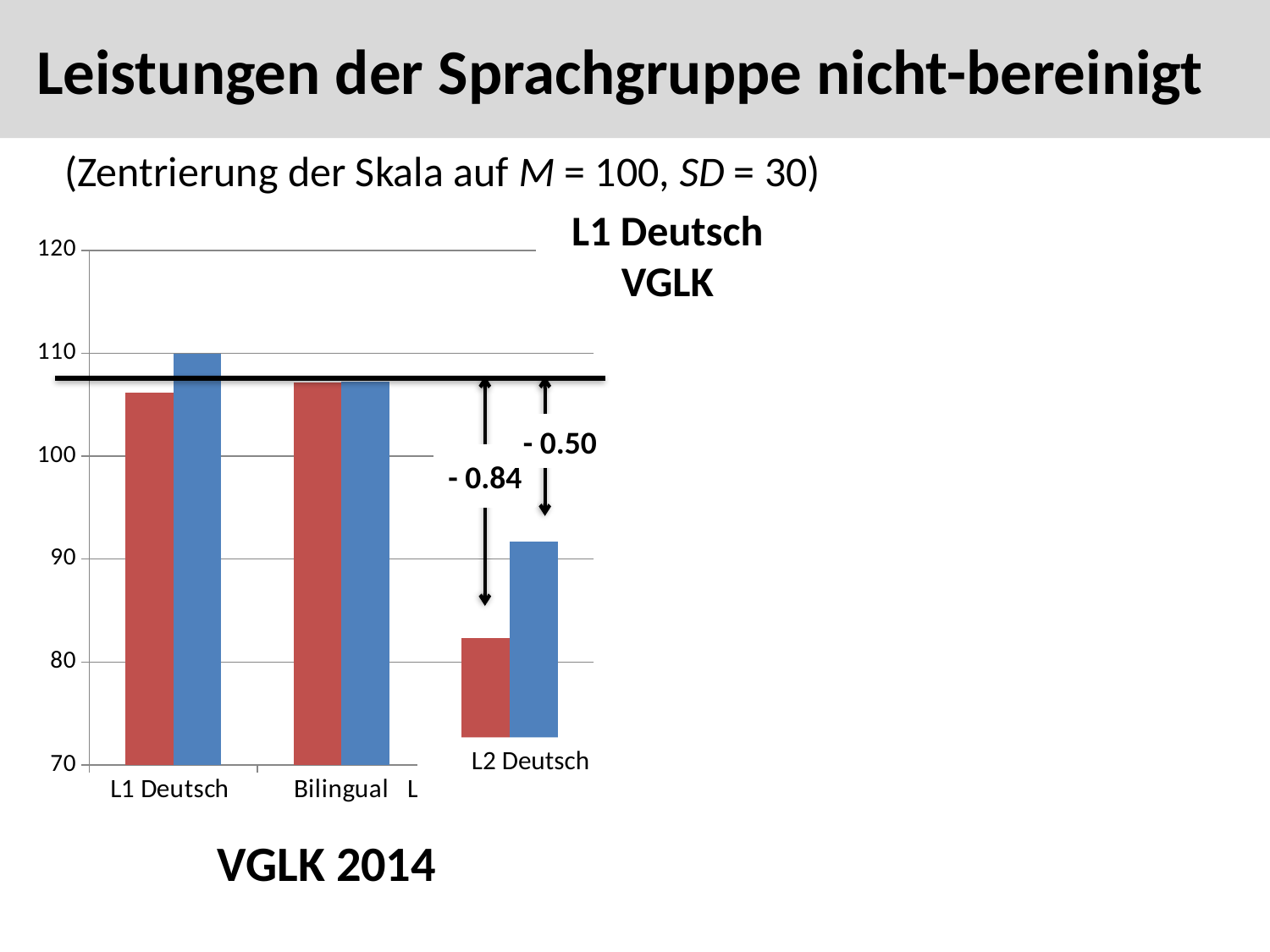
For L1 Deutsch, which bar is taller, the red one or the blue one? the blue one What value is annotated next to the arrow pointing to the red bar for L2 Deutsch? - 0.84 What label is given to the thick horizontal reference line in the chart? L1 Deutsch VGLK Is the value of the red bar for L1 Deutsch greater or less than 100? greater For L2 Deutsch, which bar is taller, the red one or the blue one? the blue one Is the value of the red bar for L2 Deutsch greater or less than 80? greater What kind of chart is shown on the slide? bar chart Which category has the lowest bars in the chart? L2 Deutsch What value is annotated next to the arrow pointing to the blue bar for L2 Deutsch? - 0.50 How many categories are shown on the x axis of the chart? 3 Is the value of the red bar for L2 Deutsch greater or less than 90? less